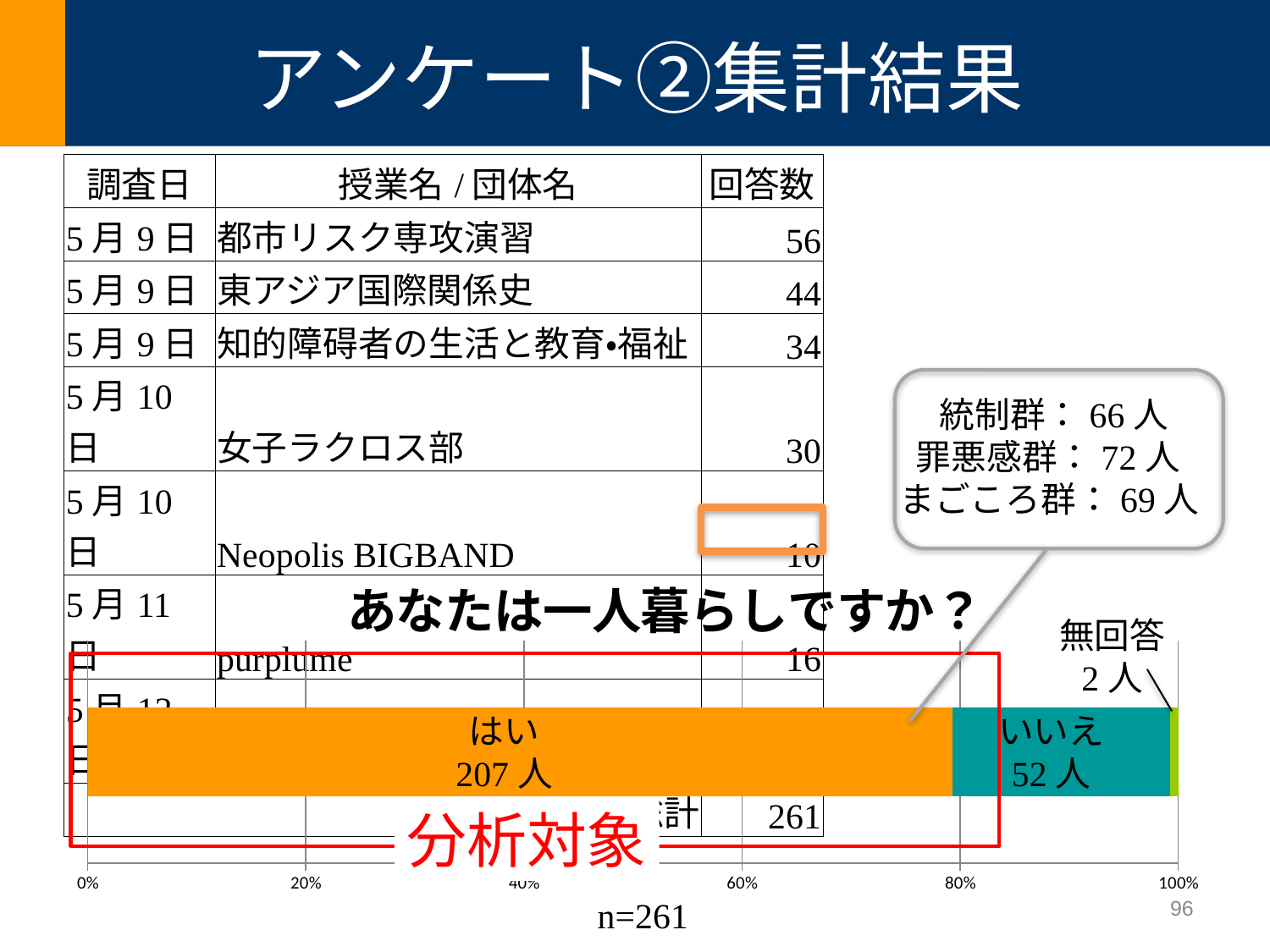
What is the title of the chart? あなたは一人暮らしですか？ What kind of chart is shown on the slide? bar chart Which response has the smallest segment in the chart? 無回答 How many people answered はい in the chart? 207 人 Which response has the largest segment in the chart? はい Which is larger, the number of はい responses or the number of いいえ responses? はい What is the difference between the number of はい and いいえ responses? 155 人 What is the total number of responses across all segments of the bar? 261 How many people answered いいえ in the chart? 52 人 Does the はい segment extend to greater or less than 60% on the axis? greater How many people are in the 無回答 segment of the chart? 2 人 How many segments does the stacked bar contain? 3